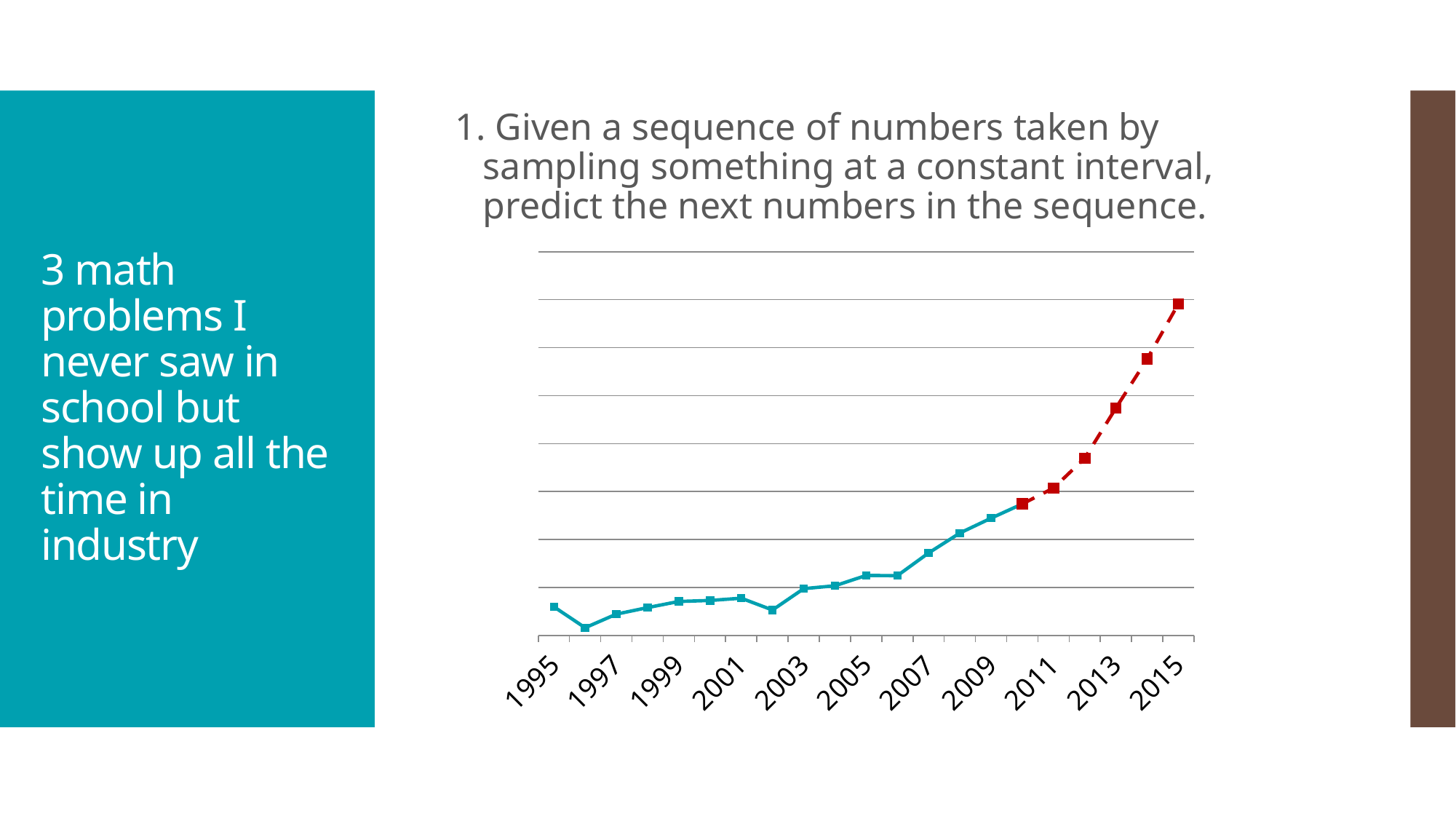
Is the solid line segment drawn in teal or in red? teal What colour is the dashed line segment at the right end of the chart? red What kind of chart is shown on the slide? line chart Which year has the lowest plotted value? 1996 Which is larger, the value for 2009 or the value for 2005? 2009 What is the last year labelled on the x axis? 2015 How many year labels are shown on the x axis? 11 Which is larger, the value for 2003 or the value for 2002? 2003 Which year has the highest plotted value? 2015 What is the first year labelled on the x axis? 1995 Do the plotted values generally rise or fall from 1995 to 2015? rise Is the value for 2015 larger or smaller than the value for 1995? larger